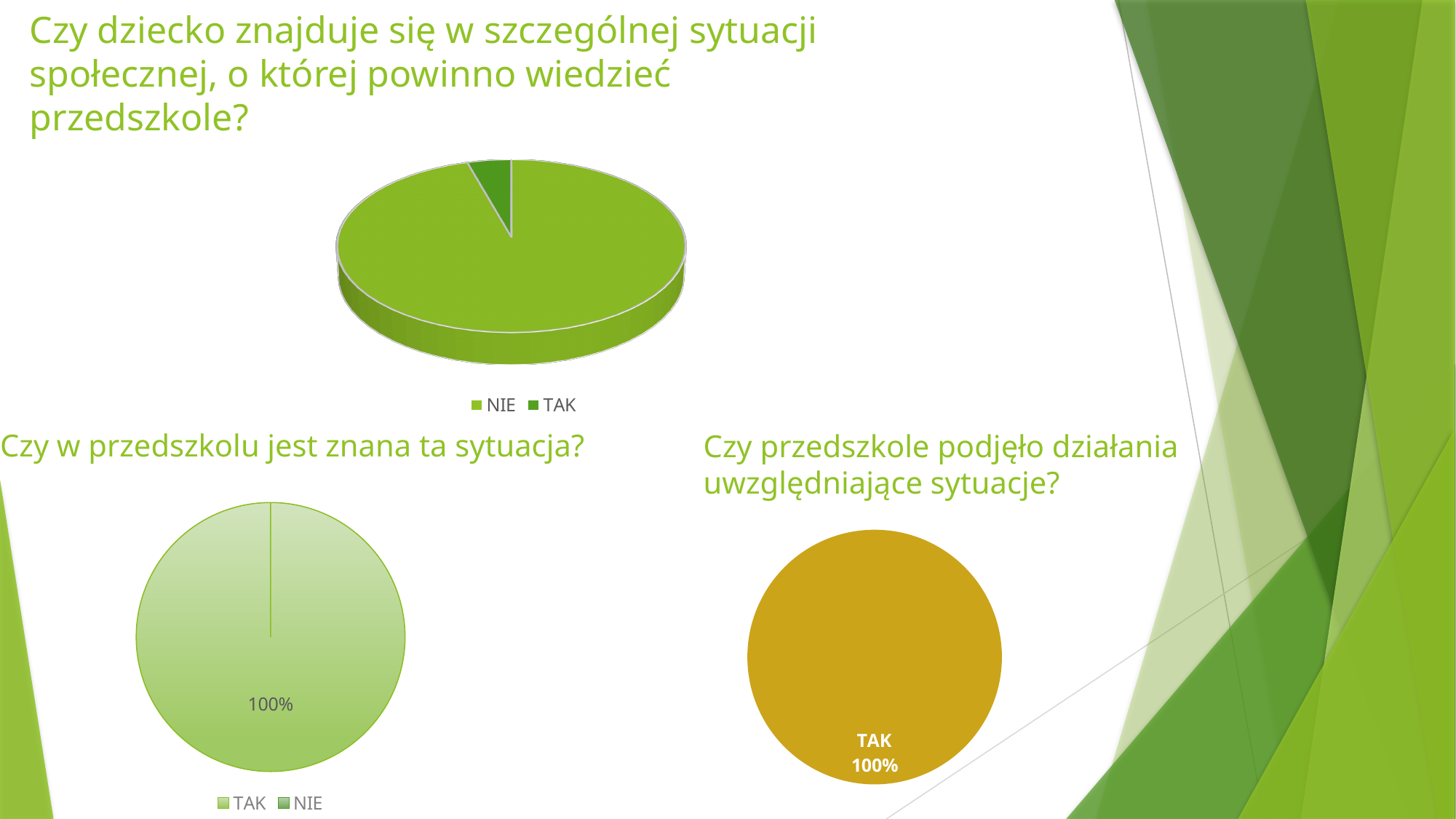
In the top pie chart, which slice is larger, NIE or TAK? NIE How many entries does the legend of the bottom-left pie chart list? 2 In the chart titled 'Czy w przedszkolu jest znana ta sytuacja?', what share of the pie does the TAK slice take? 100% What kind of chart is the top chart on the slide? pie chart How many entries does the legend of the top pie chart list? 2 In the chart titled 'Czy przedszkole podjęło działania uwzględniające sytuacje?', what share of the pie is labelled TAK? 100% How many charts are shown on the slide? 3 In the top pie chart, which category has the largest slice? NIE Which legend entry is listed first in the top pie chart's legend? NIE What kind of chart is the bottom-right chart on the slide? pie chart What colour is the pie in the chart titled 'Czy przedszkole podjęło działania uwzględniające sytuacje?' gold In the top pie chart, which category has the smallest slice? TAK